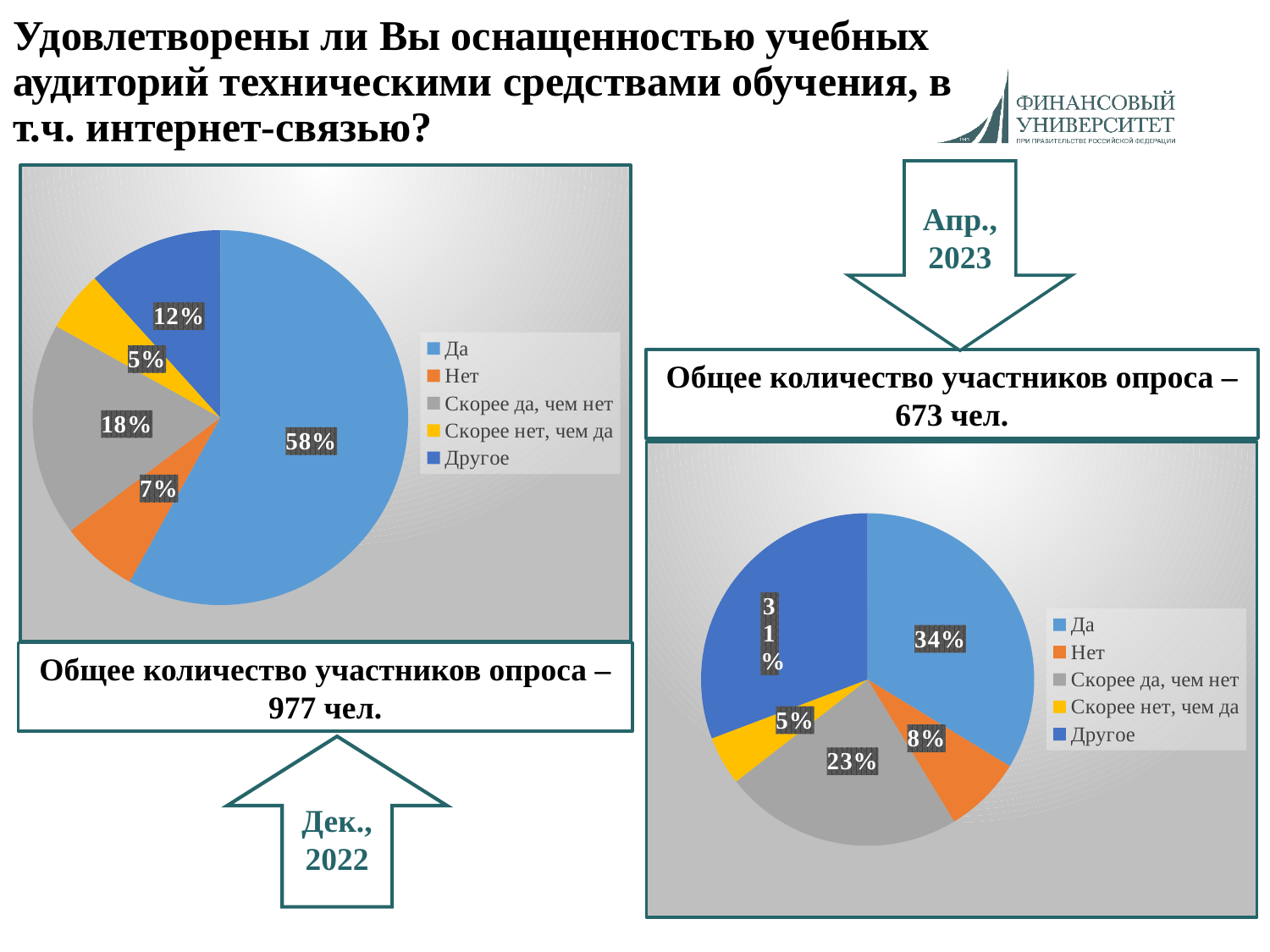
In the right pie chart (Апр., 2023), what share is labelled for "Другое"? 31% What type of chart is shown on the right side of the slide (Апр., 2023)? Pie chart In the right pie chart (Апр., 2023), which category has the smallest slice? Скорее нет, чем да In the left pie chart (Дек., 2022), what is the difference between the shares for "Да" and "Скорее да, чем нет"? 40% How many entries does the legend of the right pie chart (Апр., 2023) list? 5 In the left pie chart (Дек., 2022), what share is labelled for "Да"? 58% In the left pie chart (Дек., 2022), which category has the smallest slice? Скорее нет, чем да In the right pie chart (Апр., 2023), what share is labelled for "Скорее да, чем нет"? 23% In the left pie chart (Дек., 2022), which category has the largest slice? Да In the right pie chart (Апр., 2023), what colour is the slice for "Нет"? Orange How many slices does the left pie chart (Дек., 2022) have? 5 In the right pie chart (Апр., 2023), which is larger: the share for "Нет" or the share for "Скорее да, чем нет"? Скорее да, чем нет